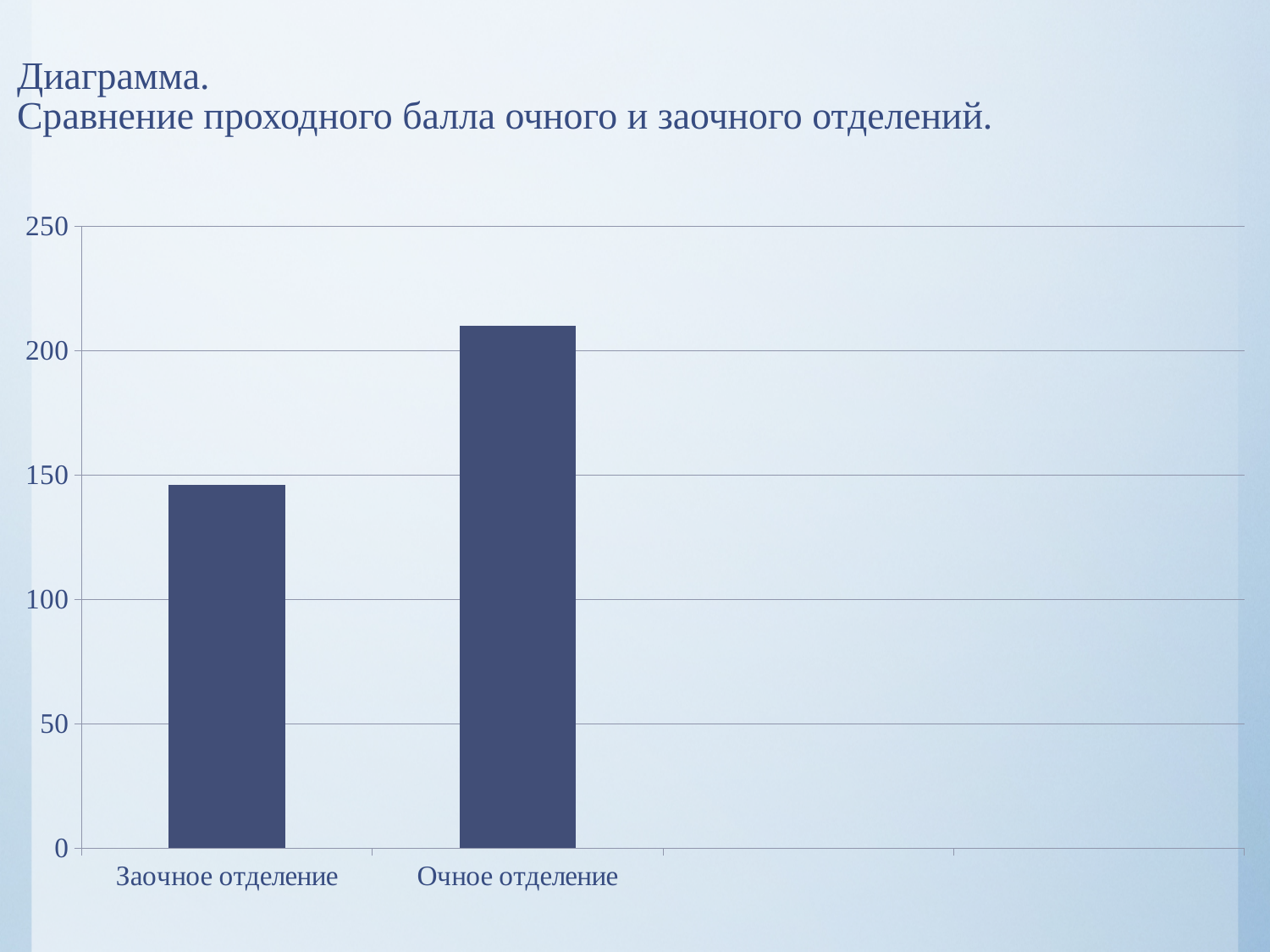
Is the value for Очное отделение greater or less than 250? less What is the title of the chart on the slide? Диаграмма. Сравнение проходного балла очного и заочного отделений. Is the value for Заочное отделение greater or less than 100? greater Which is larger, the value for Заочное отделение or the value for Очное отделение? Очное отделение What kind of chart is shown on the slide? bar chart Is the value for Очное отделение greater or less than 200? greater How many categories are plotted on the chart? 2 Do the bar values rise or fall from left to right along the x axis? rise Which category has the highest bar? Очное отделение Which category has the lowest bar? Заочное отделение What is the highest value shown on the vertical axis? 250